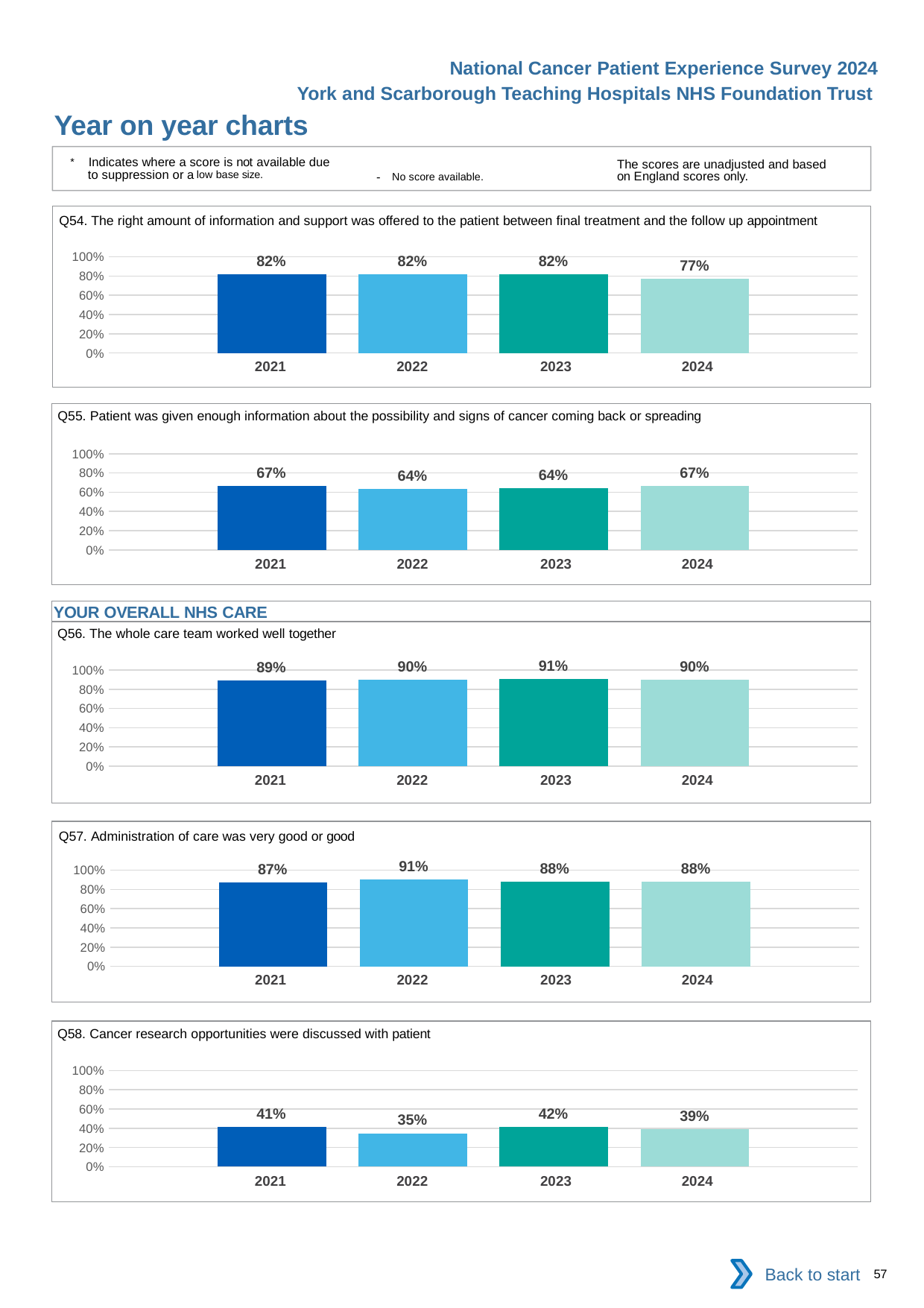
In the Q56 chart, which year has the highest value? 2023 In the Q55 chart, what is the value for 2022? 64% What kind of chart is the Q57 chart? bar chart In the Q54 chart, do the values rise or fall from 2023 to 2024? fall In the Q57 chart, what is the value for 2022? 91% In the Q54 chart, what is the value for 2024? 77% How many years are shown in the Q56 chart? 4 In the Q54 chart, is the value for 2021 or 2024 larger? 2021 In the Q57 chart, which year has the lowest value? 2021 In the Q58 chart, what is the difference between the 2023 and 2022 values? 7% In the Q58 chart, is the value for 2022 greater or less than 40%? less How many charts are shown on the slide? 5